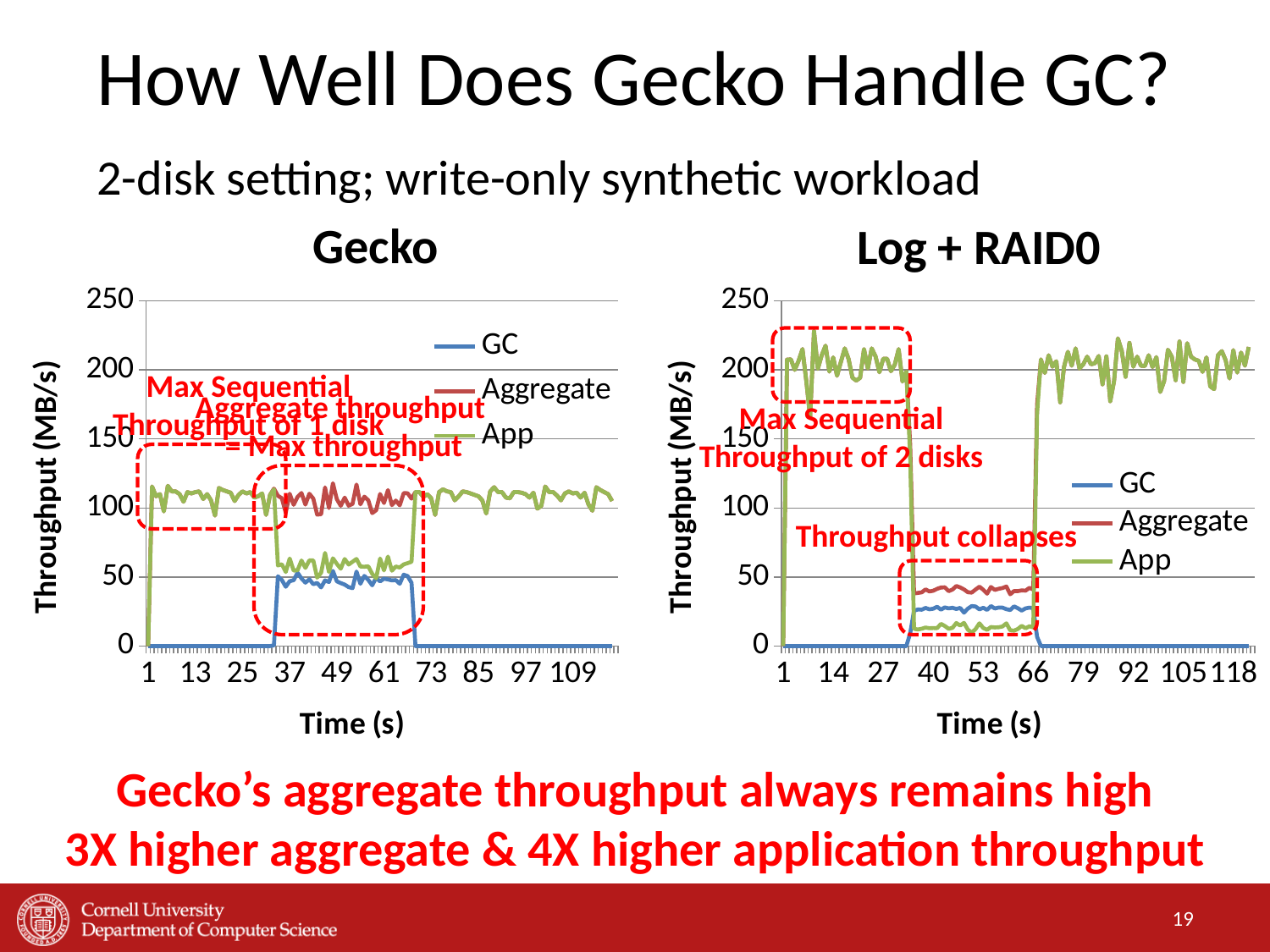
In the Gecko chart, is the App throughput at time 85 s greater or less than 50? greater How many series does the legend of the Log + RAID0 chart list? 3 In the Log + RAID0 chart, is the App throughput at time 14 s greater or less than 150? greater In the Gecko chart, is the GC throughput at time 13 s greater or less than 50? less In the Log + RAID0 chart, at time 53 s, which series has the higher throughput: GC or App? GC What is the y-axis title of the Log + RAID0 chart? Throughput (MB/s) What kind of chart is the Gecko chart? line chart In the Log + RAID0 chart, at time 53 s, which series has the higher throughput: Aggregate or App? Aggregate What are the series names in the legend of the Gecko chart? GC, Aggregate, App